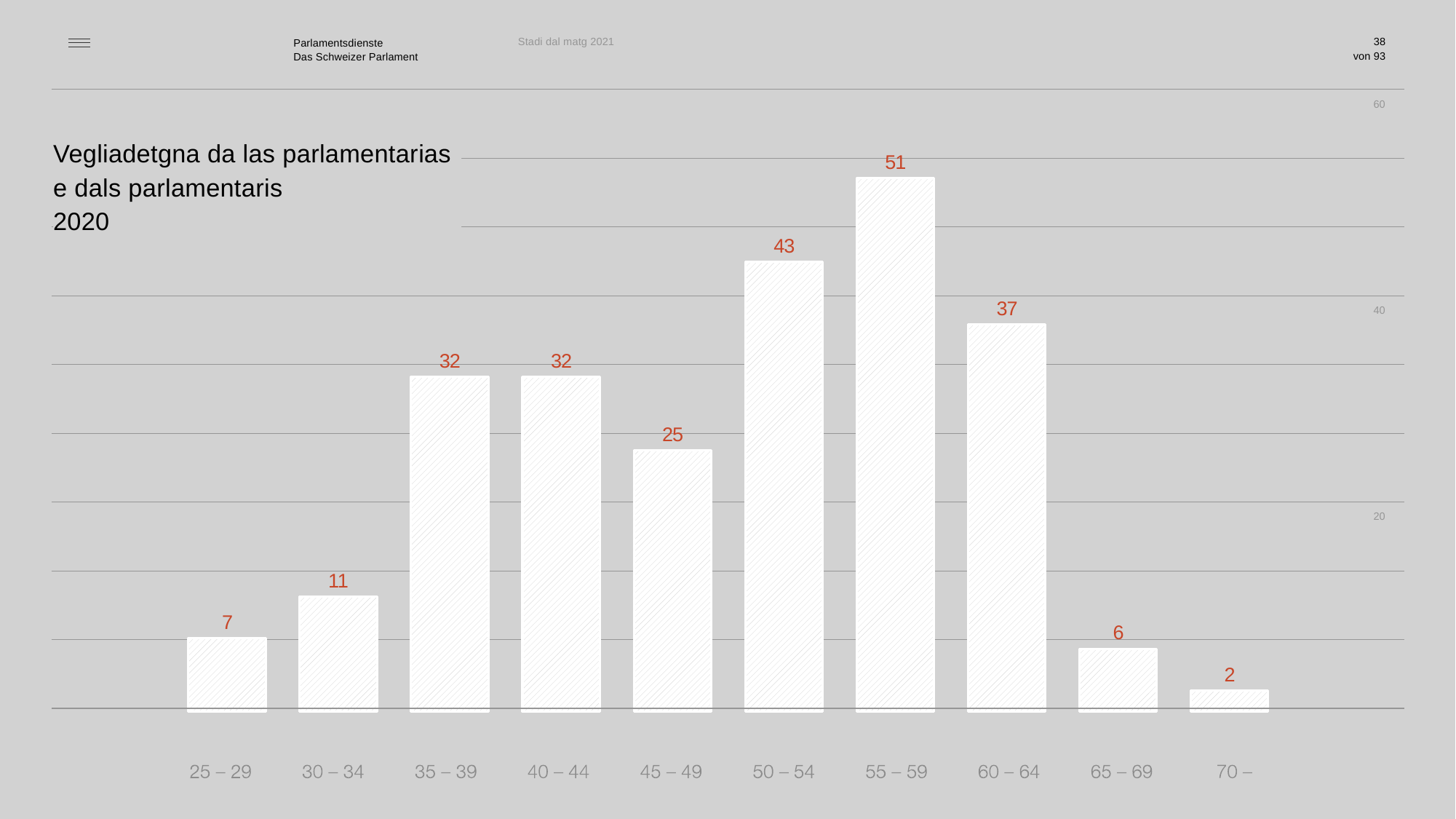
What kind of chart is shown on the slide? bar chart What is the value for the 45 – 49 age group? 25 What is the value for the 55 – 59 age group? 51 Do the values rise or fall from 25 – 29 to 55 – 59? rise Which age group has the highest value? 55 – 59 Which age group has the lowest value? 70 – What is the value for the 30 – 34 age group? 11 Is the value for 50 – 54 greater or less than 40? greater What is the difference between the values for 50 – 54 and 60 – 64? 6 What year is given in the chart title? 2020 Which is larger, the value for 35 – 39 or the value for 45 – 49? 35 – 39 How many age groups are shown on the x axis? 10